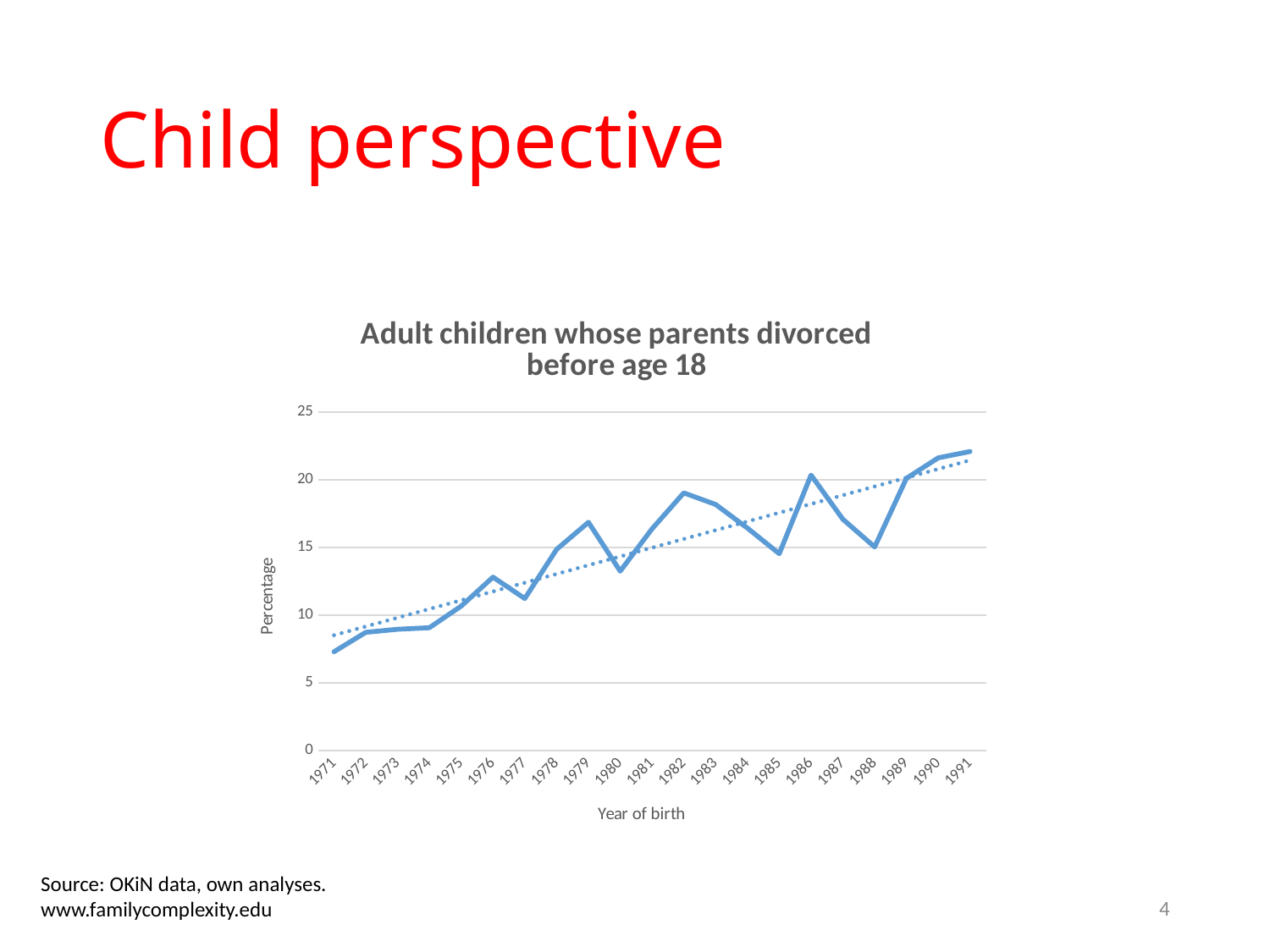
Which has the larger value, 1982 or 1980? 1982 How many years of birth are plotted along the x axis? 21 Which has the larger value, 1988 or 1989? 1989 Which year of birth has the highest percentage? 1991 Is the value for 1971 greater or less than 10? less Do the values generally rise or fall from 1971 to 1991? rise Is the value for 1985 greater or less than 15? less What kind of chart is shown on the slide? line chart What is the label of the x axis? Year of birth Is the value for 1986 greater or less than 20? greater Which year of birth has the lowest percentage? 1971 What is the title of the chart? Adult children whose parents divorced before age 18